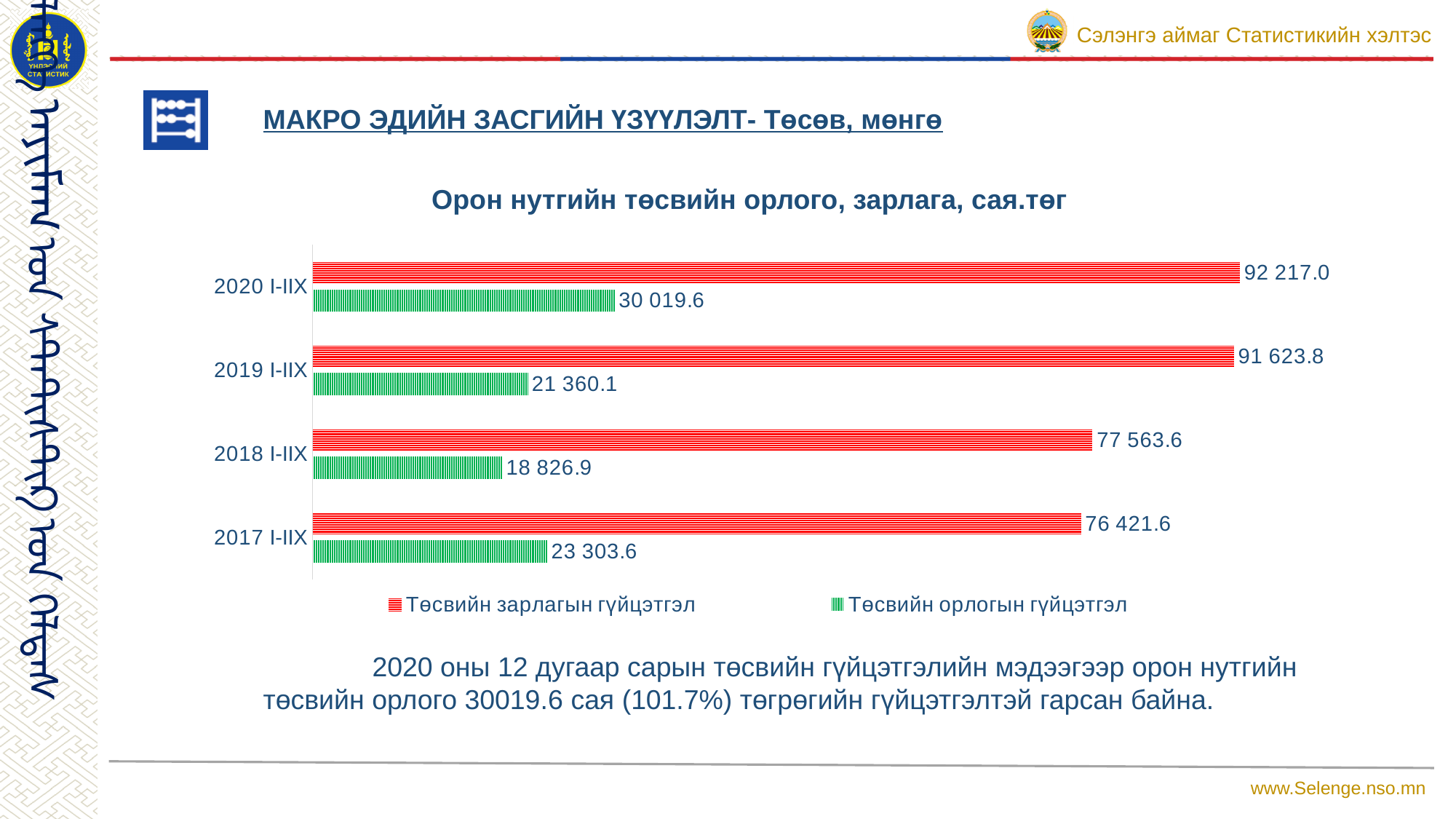
How many series does the legend list? 2 Which period has the lowest value of Төсвийн орлогын гүйцэтгэл? 2018 I-IIX What is the value of Төсвийн орлогын гүйцэтгэл for 2017 I-IIX? 23 303.6 How many periods are shown on the chart? 4 Which is larger: Төсвийн орлогын гүйцэтгэл for 2017 I-IIX or for 2019 I-IIX? 2017 I-IIX What is the value of Төсвийн орлогын гүйцэтгэл for 2019 I-IIX? 21 360.1 What is the value of Төсвийн зарлагын гүйцэтгэл for 2020 I-IIX? 92 217.0 What kind of chart is shown on the slide? Bar chart What is the difference between Төсвийн зарлагын гүйцэтгэл and Төсвийн орлогын гүйцэтгэл for 2020 I-IIX? 62 197.4 Which period has the highest value of Төсвийн орлогын гүйцэтгэл? 2020 I-IIX What is the value of Төсвийн зарлагын гүйцэтгэл for 2018 I-IIX? 77 563.6 Which period has the lowest value of Төсвийн зарлагын гүйцэтгэл? 2017 I-IIX